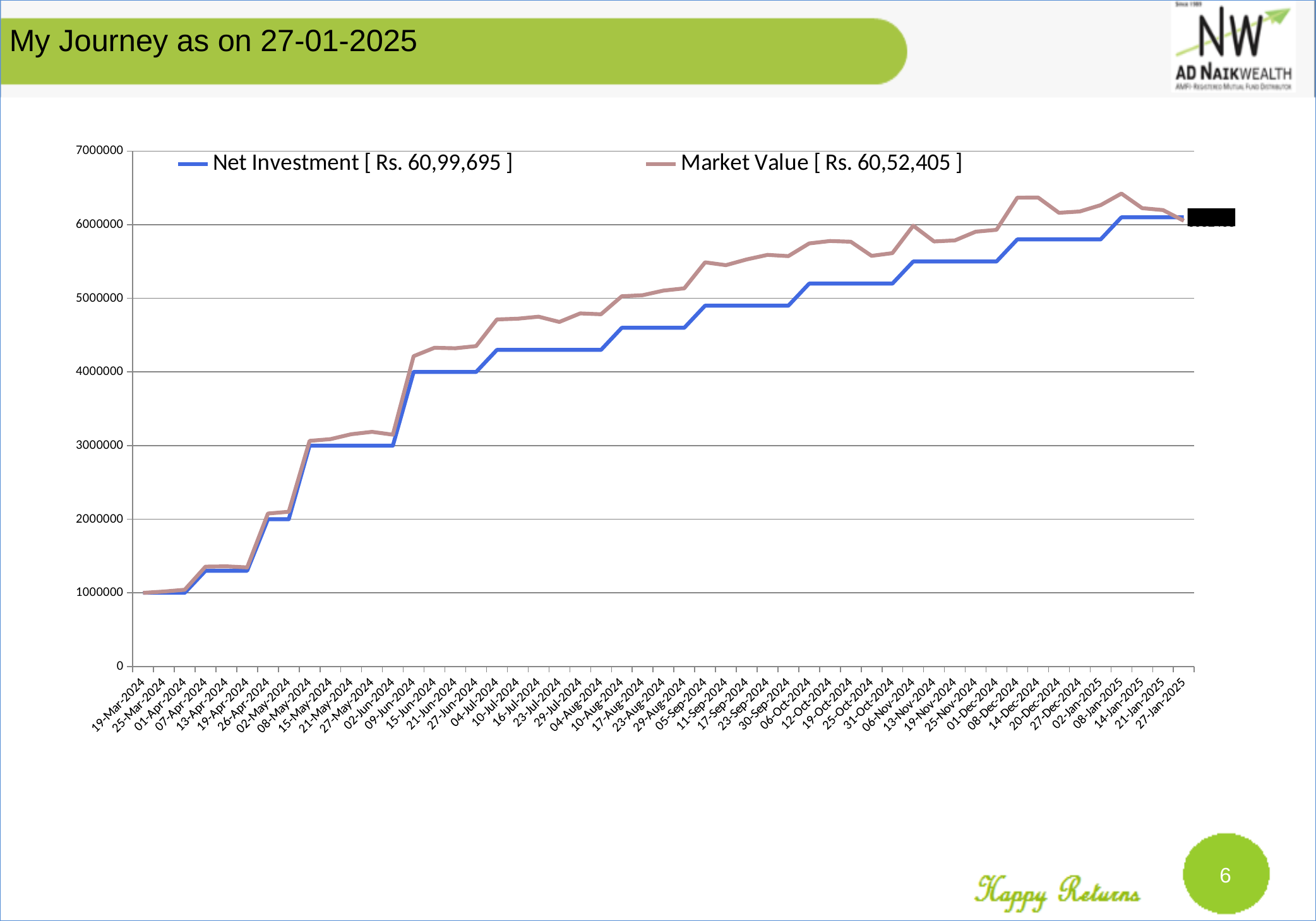
What are the two series named in the chart legend? Net Investment and Market Value Do the Net Investment values generally rise or fall from 19-Mar-2024 to 27-Jan-2025? Rise According to the legend, which is larger: Net Investment or Market Value? Net Investment What is the title of the slide containing the chart? My Journey as on 27-01-2025 Is the Market Value on 08-Dec-2024 greater or less than 6000000? greater Is the Net Investment on 13-Apr-2024 greater or less than 2000000? less How many series does the chart legend list? 2 What type of chart is shown on the slide? Line chart What is the difference between the Net Investment and Market Value figures shown in the legend? Rs. 47,290 Is the Market Value on 27-Jun-2024 greater or less than 4000000? greater What is the Market Value shown in the legend? Rs. 60,52,405 What is the Net Investment value shown in the legend? Rs. 60,99,695